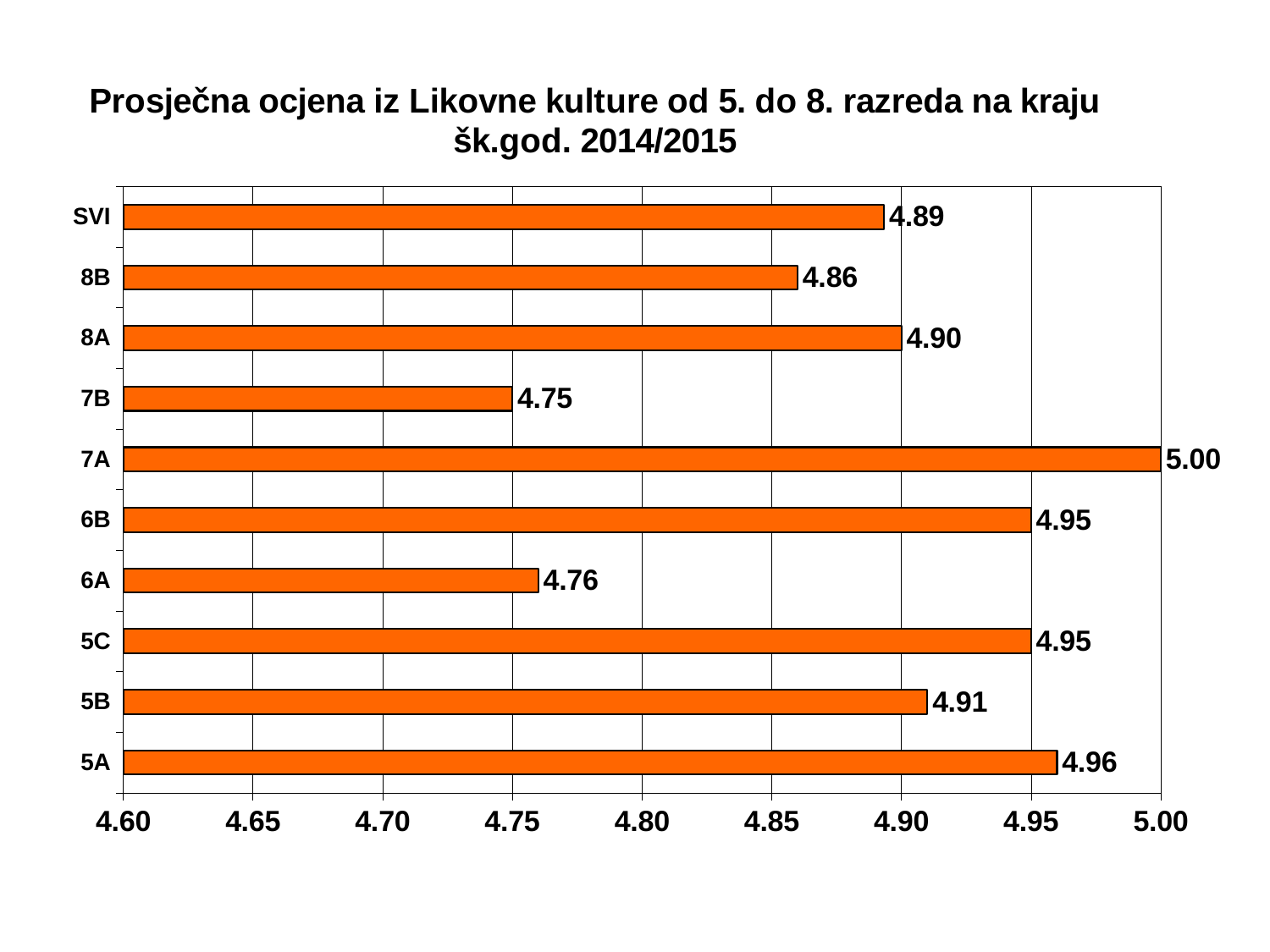
What is the difference between the values for 7A and 7B? 0.25 What kind of chart is shown on the slide? bar chart What is the average grade for 6A? 4.76 Which class has the highest average grade? 7A What is the minimum value shown on the horizontal axis? 4.60 What is the value shown for SVI? 4.89 What is the average grade for 7A? 5.00 How many categories are shown on the chart? 10 Which class has the lowest average grade? 7B What is the difference between the values for 5A and 8B? 0.10 Which is larger, the value for 8A or the value for 8B? 8A Is the value for 6A greater or less than 4.80? less